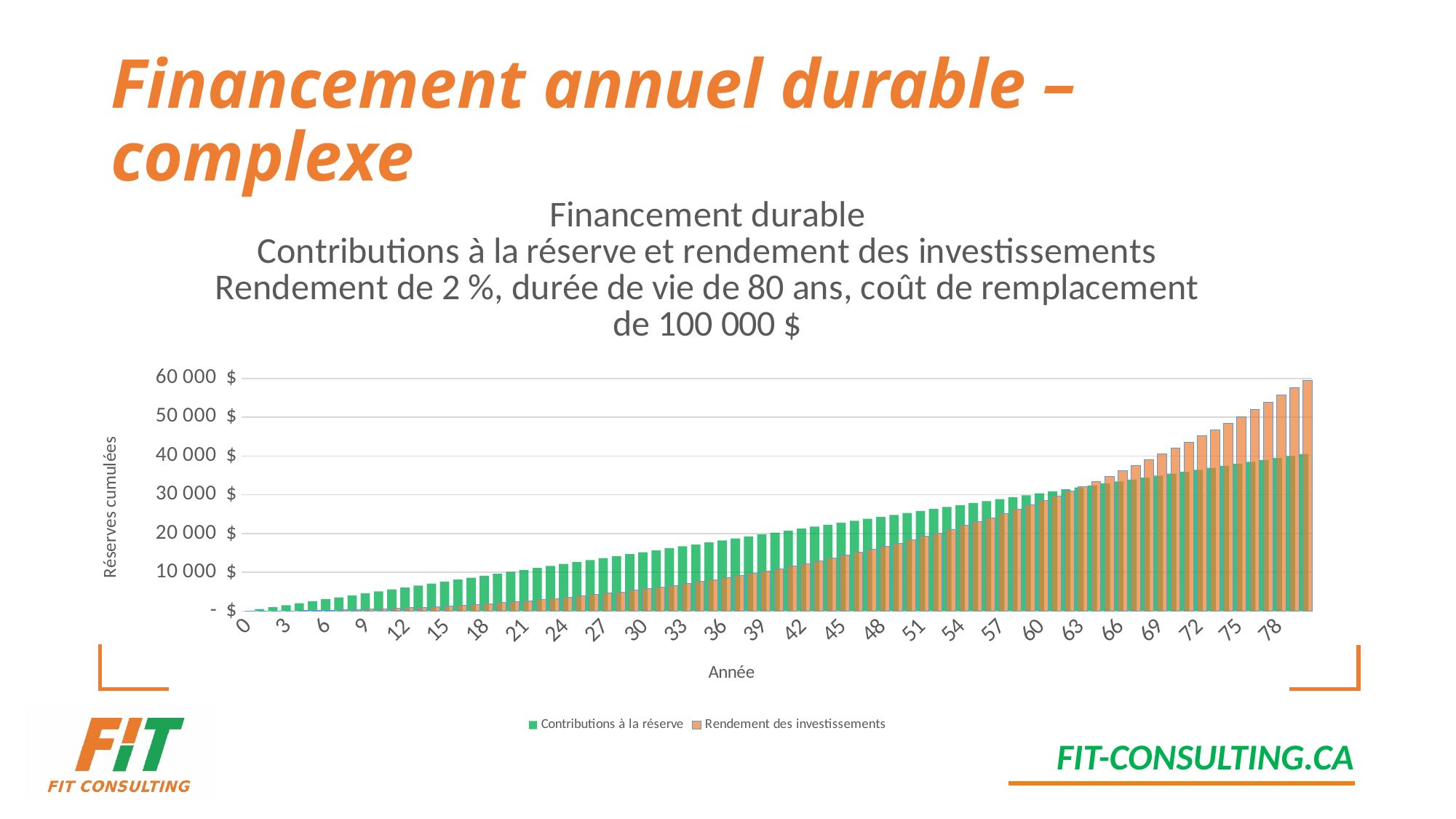
What is the label of the vertical axis? Réserves cumulées At year 78, which series has the larger value: Contributions à la réserve or Rendement des investissements? Rendement des investissements Do the values for Contributions à la réserve rise or fall along the x axis? rise What kind of chart is shown on the slide? bar chart Is the value for Rendement des investissements at year 72 greater or less than 40 000 $? greater Which series is shown in green in the legend? Contributions à la réserve How many series does the legend list? 2 Is the value for Rendement des investissements at year 30 greater or less than 10 000 $? less Do the values for Rendement des investissements rise or fall as the year increases? rise At year 30, which series has the larger value: Contributions à la réserve or Rendement des investissements? Contributions à la réserve Is the value for Contributions à la réserve at year 30 greater or less than 10 000 $? greater